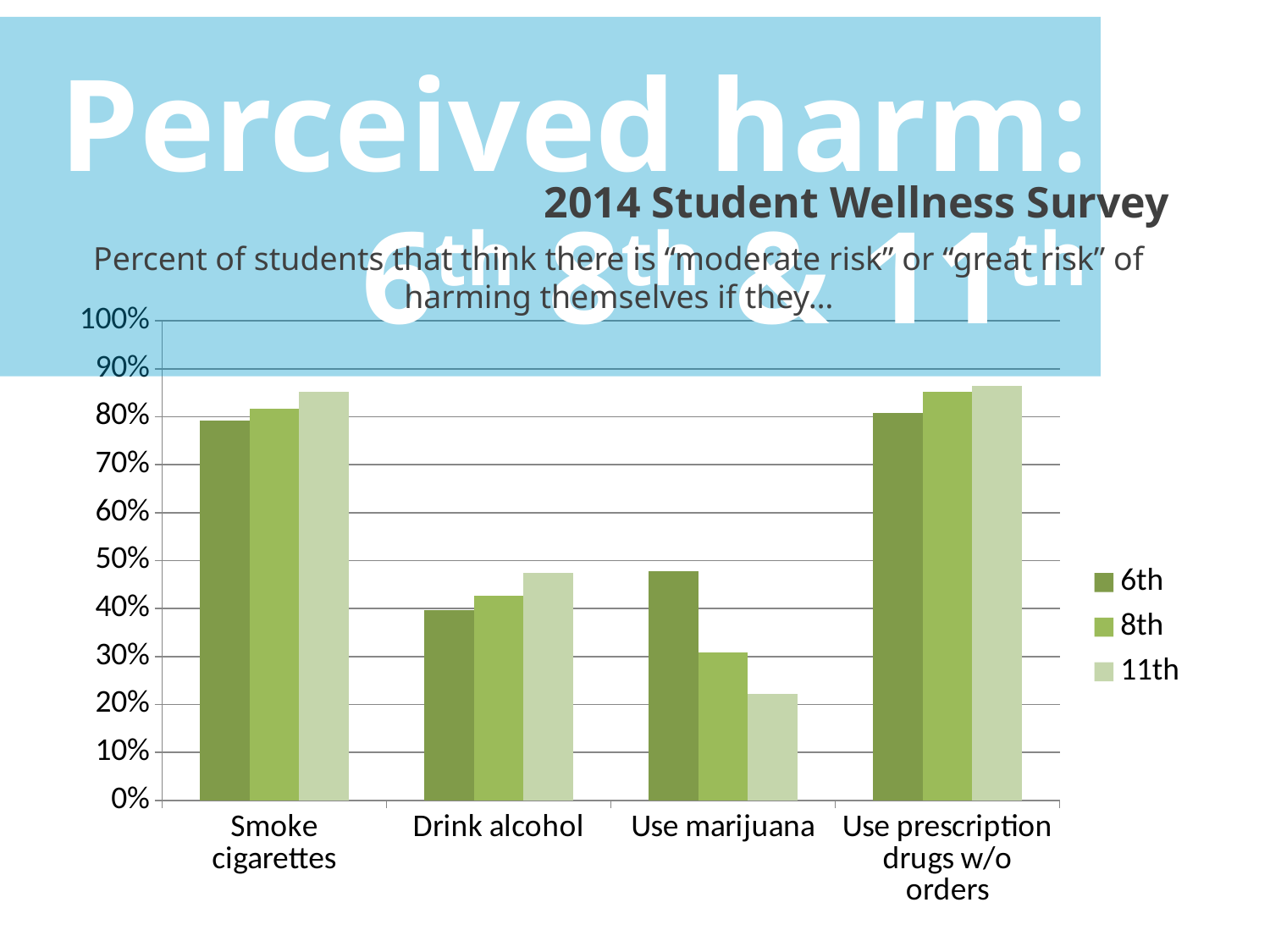
How many categories are shown on the x axis of the chart? 4 Is the value for 6th graders for Drink alcohol greater or less than 50%? less Is the value for 6th graders for Smoke cigarettes greater or less than 70%? greater How many series does the chart's legend list? 3 Is the value for 11th graders for Use marijuana greater or less than 30%? less For Use marijuana, do the values rise or fall from 6th to 8th to 11th grade? fall Which category has the lowest value for 6th graders? Drink alcohol What kind of chart is shown on the slide? bar chart Which grade levels are listed in the chart's legend? 6th, 8th, 11th For Drink alcohol, which is larger: the value for 6th graders or for 11th graders? 11th For Use marijuana, which is larger: the value for 6th graders or for 11th graders? 6th